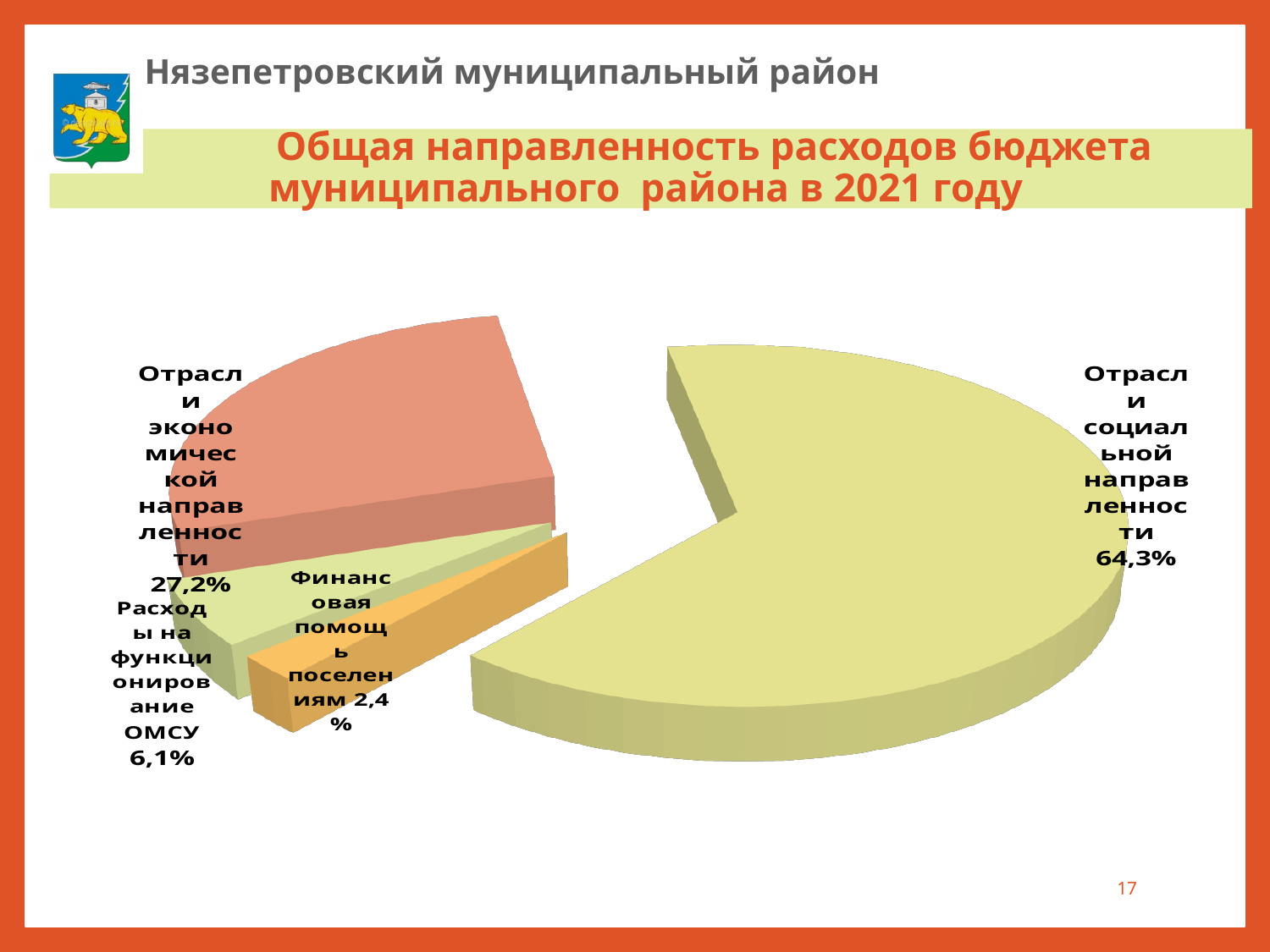
What share of the budget expenditures goes to Финансовая помощь поселениям? 2,4% What is the difference in percentage points between Отрасли социальной направленности and Отрасли экономической направленности? 37,1 What share of the budget expenditures goes to Расходы на функционирование ОМСУ? 6,1% How many slices does the pie chart have? 4 Which category has the largest share of the budget expenditures? Отрасли социальной направленности What share of the budget expenditures goes to Отрасли экономической направленности? 27,2% Which is larger: the share for Расходы на функционирование ОМСУ or the share for Финансовая помощь поселениям? Расходы на функционирование ОМСУ Which category has the smallest share of the budget expenditures? Финансовая помощь поселениям What share of the budget expenditures goes to Отрасли социальной направленности? 64,3% What colour is the slice for Отрасли социальной направленности? Yellow What kind of chart is shown on the slide? Pie chart What is the combined share of Расходы на функционирование ОМСУ and Финансовая помощь поселениям? 8,5%